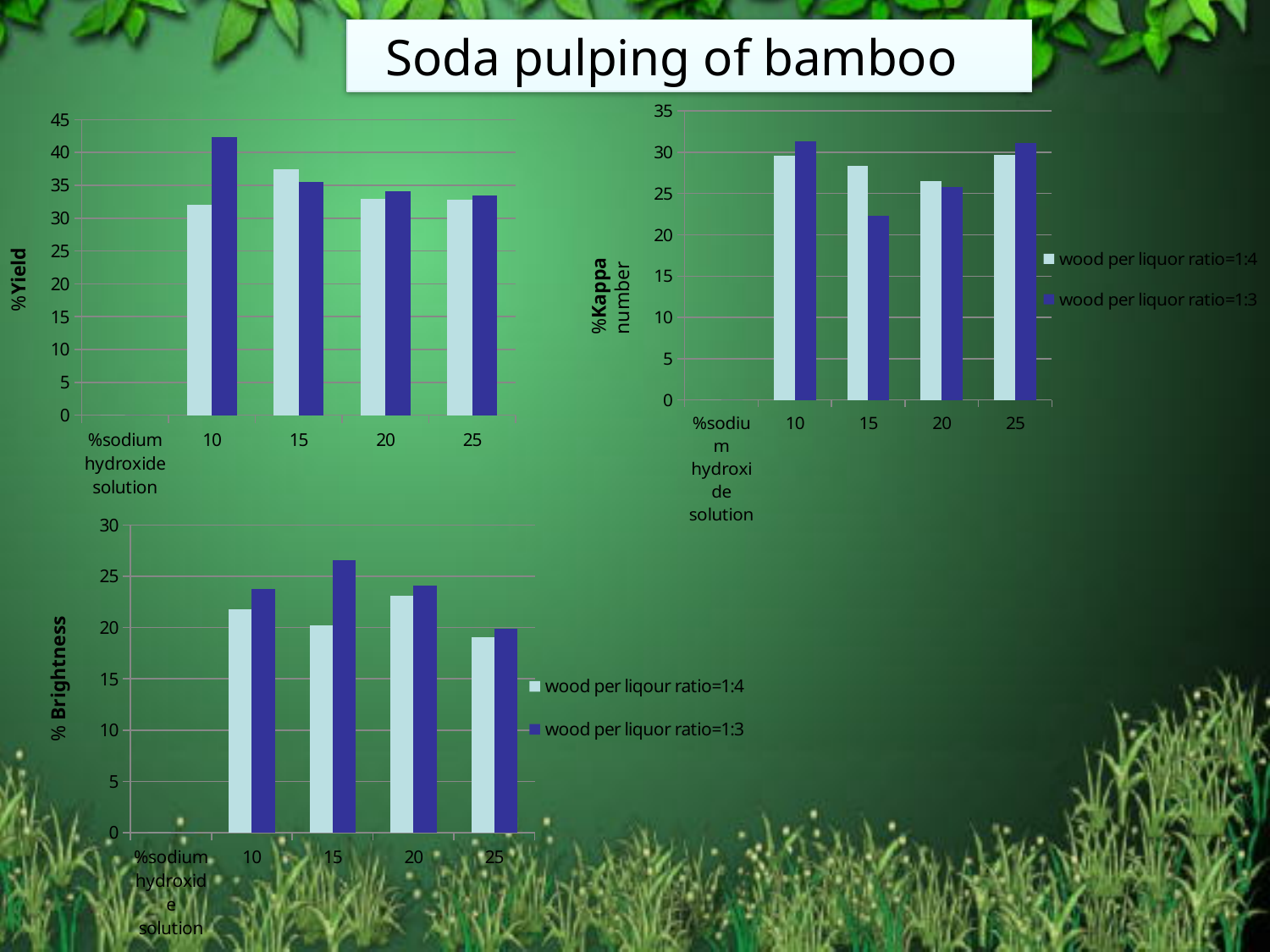
In the %Kappa number chart, which series is shown by the dark blue bars? wood per liquor ratio=1:3 In the % Brightness chart at 15% sodium hydroxide, which series has the larger value: wood per liquor ratio=1:4 or 1:3? wood per liquor ratio=1:3 In the %Yield chart, is the value for wood per liquor ratio=1:3 at 10% sodium hydroxide greater or less than 40? greater In the %Yield chart, at which sodium hydroxide concentration is the wood per liquor ratio=1:3 bar highest? 10 How many series does the legend of the %Kappa number chart list? 2 In the % Brightness chart, at which sodium hydroxide concentration is the wood per liquor ratio=1:3 bar highest? 15 In the %Kappa number chart, is the value for wood per liquor ratio=1:3 at 15% sodium hydroxide greater or less than 25? less In the %Kappa number chart, at which sodium hydroxide concentration is the wood per liquor ratio=1:3 bar lowest? 15 In the % Brightness chart, is the value for wood per liquor ratio=1:4 at 25% sodium hydroxide greater or less than 20? less What kind of chart is the %Yield chart at the top left of the slide? Bar chart In the %Yield chart at 15% sodium hydroxide, which series has the larger value: wood per liquor ratio=1:4 or 1:3? wood per liquor ratio=1:4 In the % Brightness chart, how many sodium hydroxide concentrations (numeric categories) are plotted? 4